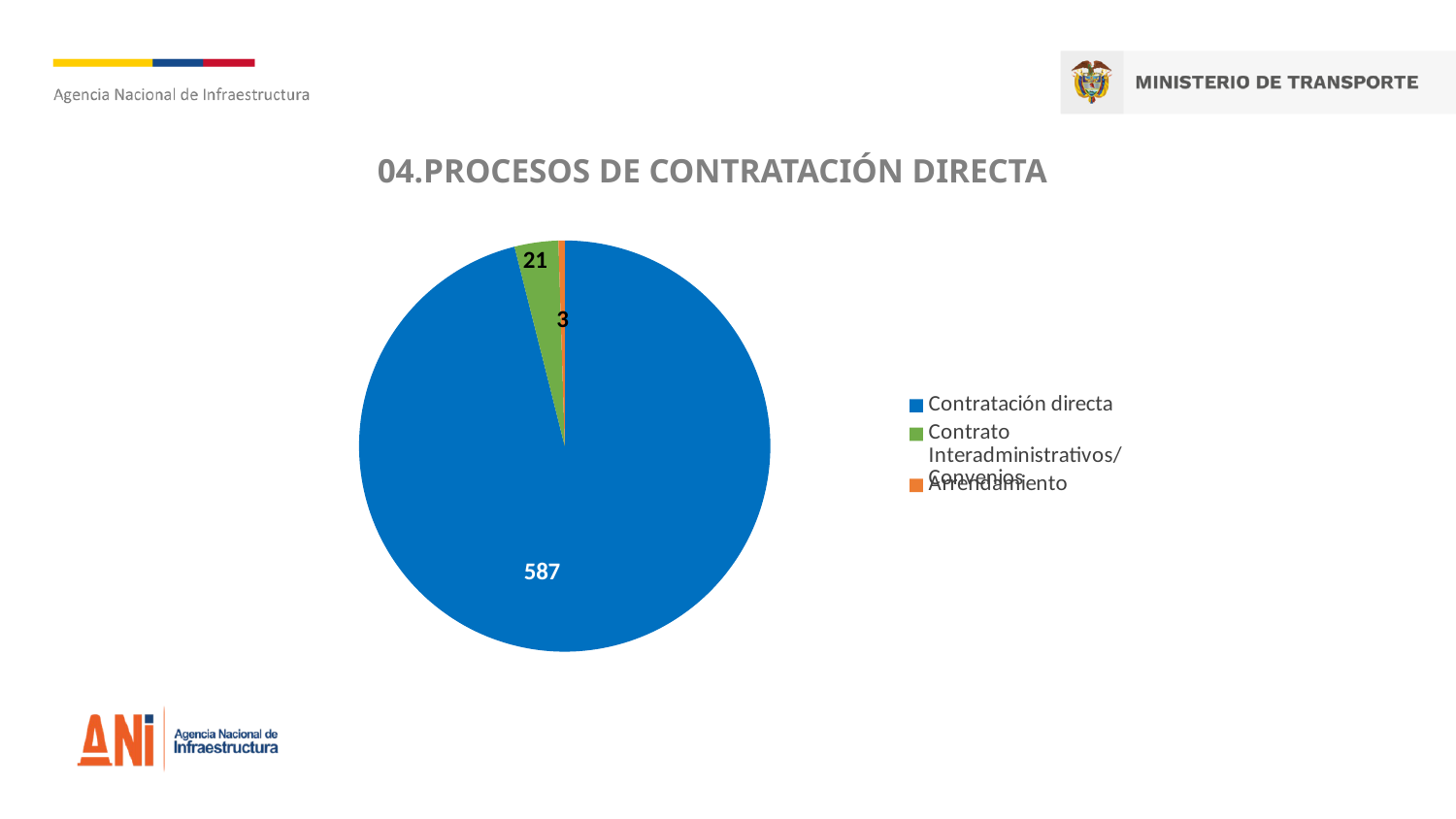
What is the difference between the values for Contrato Interadministrativos/Convenios and Arrendamiento? 18 What is the title of the slide containing the pie chart? 04.PROCESOS DE CONTRATACIÓN DIRECTA Which category has the smallest slice of the pie? Arrendamiento How many categories does the pie chart show? 3 What is the total of all the values shown in the pie chart? 611 What is the value for Arrendamiento? 3 What is the value for Contrato Interadministrativos/Convenios? 21 What kind of chart is shown on the slide? Pie chart What is the value for Contratación directa? 587 Which category has the largest slice of the pie? Contratación directa Which is larger, the value for Contrato Interadministrativos/Convenios or the value for Arrendamiento? Contrato Interadministrativos/Convenios What is the difference between the values for Contratación directa and Contrato Interadministrativos/Convenios? 566